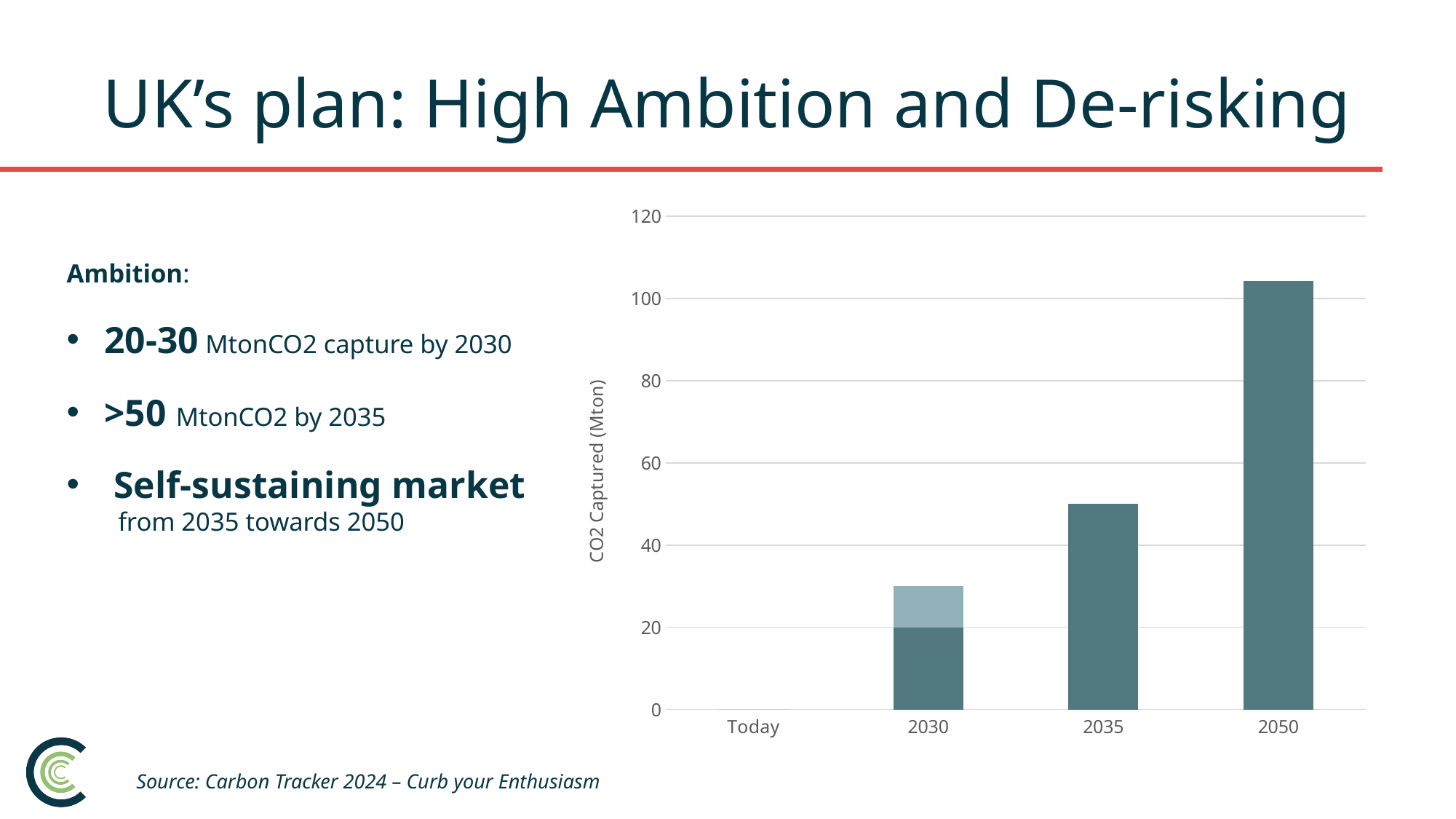
Is the total value for 2030 greater or less than 40? less Is the value for 2035 greater or less than 60? less In the 2030 bar, at what value does the darker lower segment end? 20 What is the label on the y axis of the chart? CO2 Captured (Mton) Which is larger, the value for 2035 or the value for 2030? 2035 Is the value for 2035 greater or less than 40? greater Which category has the lowest value in the chart? Today Do the values rise or fall from Today to 2050 along the x axis? rise Which category has the highest value in the chart? 2050 What kind of chart is shown on the slide? bar chart How many categories are shown on the x axis of the chart? 4